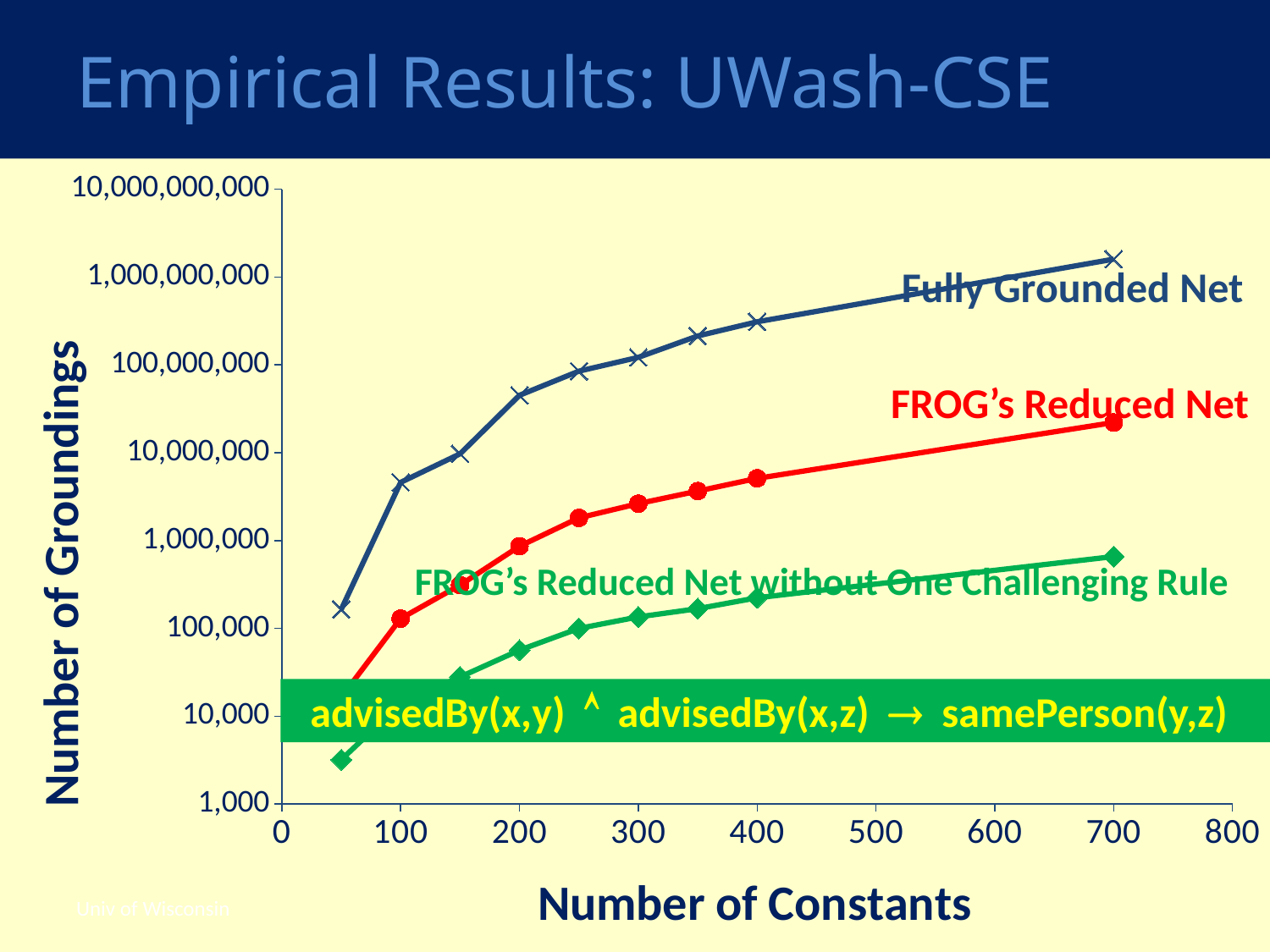
What is the label of the y axis? Number of Groundings Is the value for FROG's Reduced Net at 700 constants greater or less than 10,000,000? greater Does the number of groundings for FROG's Reduced Net rise or fall as the number of constants increases? rise Which is larger at 300 constants: Fully Grounded Net or FROG's Reduced Net? Fully Grounded Net Which series has the lowest number of groundings at 700 constants? FROG's Reduced Net without One Challenging Rule Which series has the highest number of groundings at 700 constants? Fully Grounded Net Is the value for FROG's Reduced Net without One Challenging Rule at 700 constants greater or less than 1,000,000? less Is the value for Fully Grounded Net at 700 constants greater or less than 1,000,000,000? greater What kind of chart is shown on the slide? line chart What is the label of the x axis? Number of Constants How many series are plotted on the chart? 3